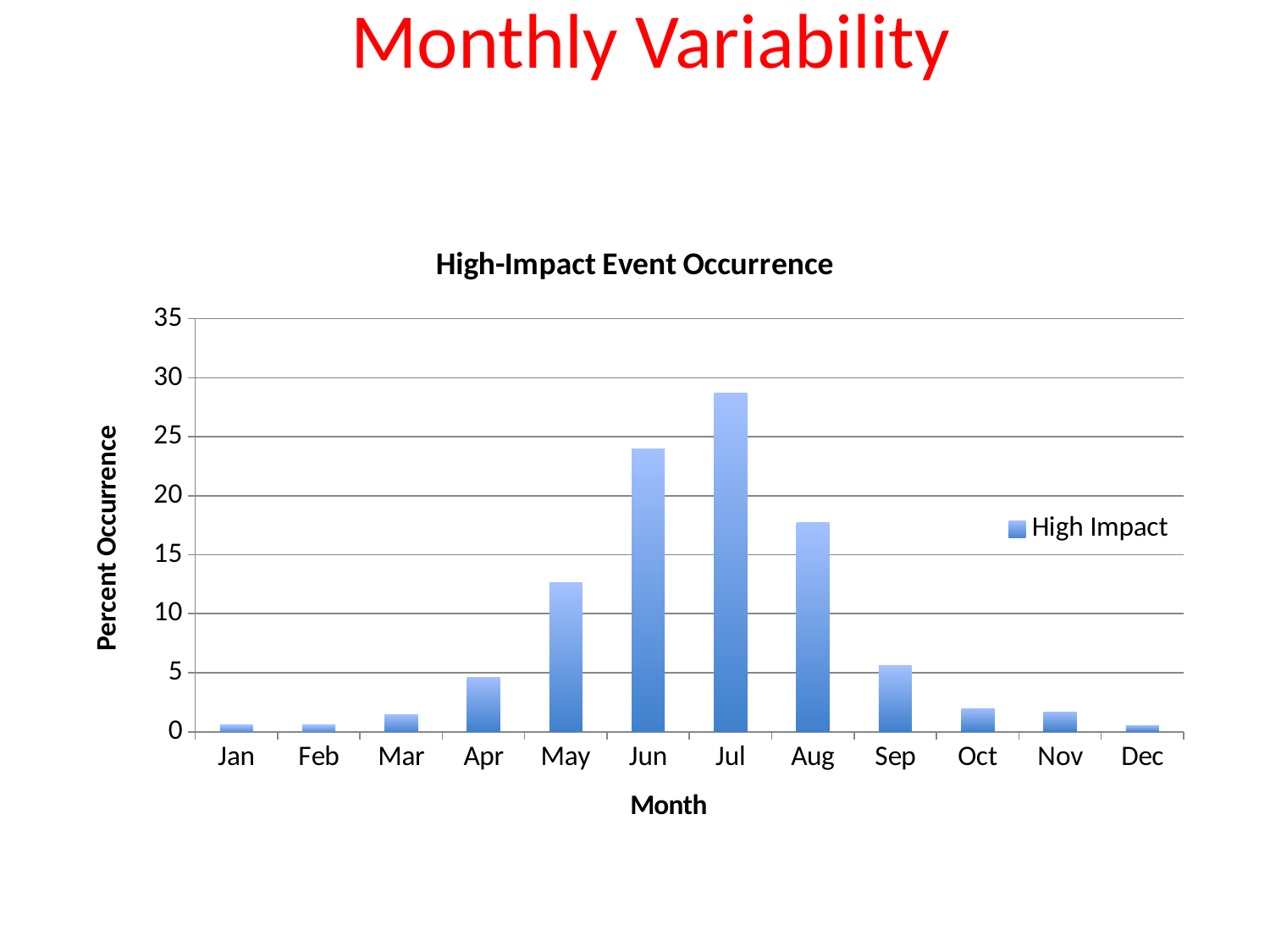
Is the value for Aug greater or less than 20? less What type of chart is shown on the slide? bar chart What is the title of the chart? High-Impact Event Occurrence Which is larger, the value for Jun or the value for Aug? Jun Which month has the highest percent occurrence? Jul Is the value for Jul greater or less than 25? greater How many series does the legend list? 1 Is the value for May greater or less than 10? greater Do the values rise or fall from Jul to Dec? fall How many months are shown on the x axis? 12